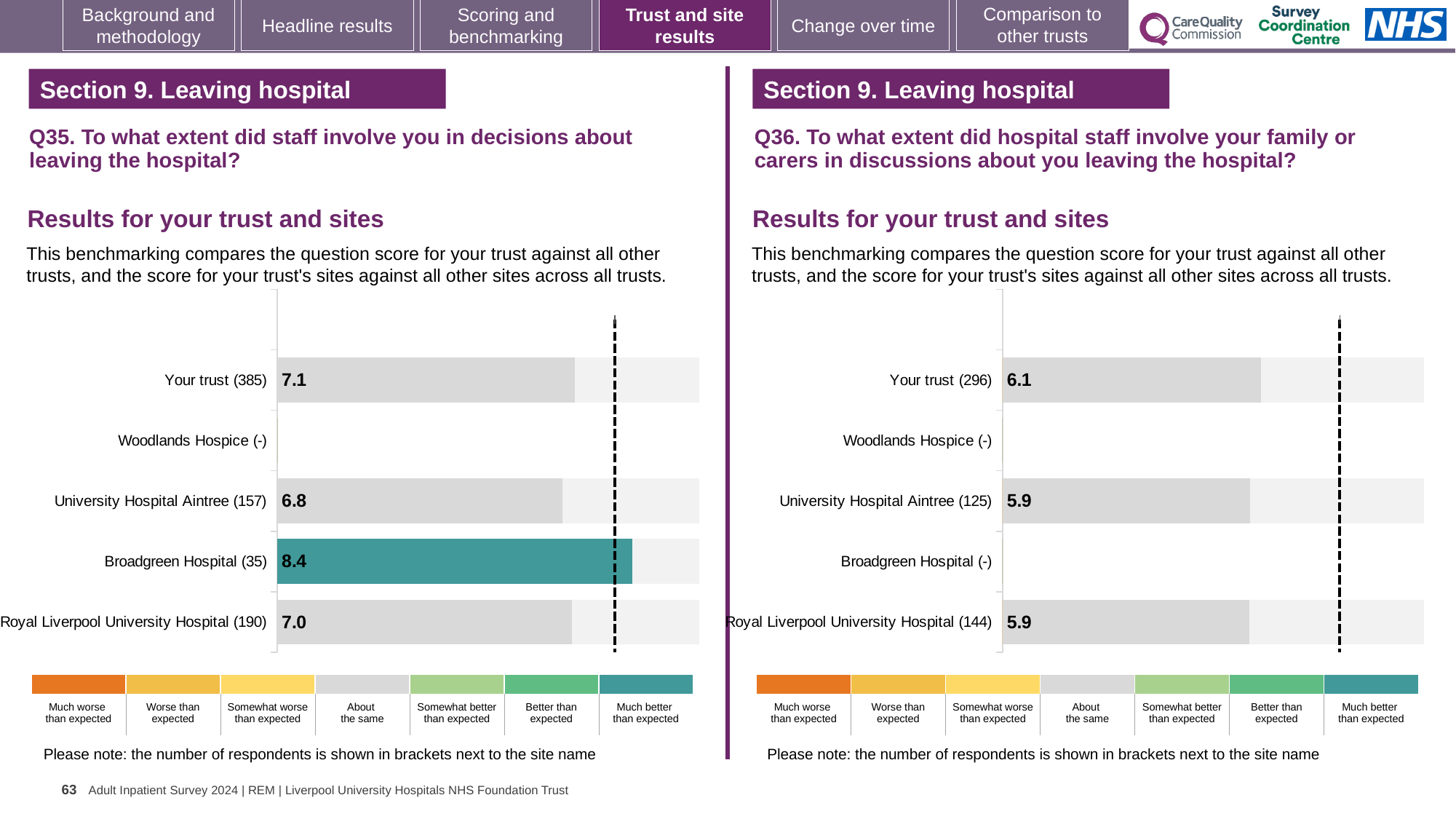
In the Q35 chart on the left, which site has the highest score? Broadgreen Hospital (35) In the Q35 chart on the left, what is the difference between the scores for Broadgreen Hospital (35) and Royal Liverpool University Hospital (190)? 1.4 What kind of chart is the Q35 chart on the left? Bar chart In the Q35 chart on the left, which has the higher score, Your trust (385) or University Hospital Aintree (157)? Your trust (385) In the Q36 chart on the right, what is the difference between the scores for Your trust (296) and University Hospital Aintree (125)? 0.2 In the Q35 chart on the left, what is the score for Your trust (385)? 7.1 In the Q35 chart on the left, which benchmark category does the colour of the Broadgreen Hospital (35) bar correspond to? Much better than expected In the Q36 chart on the right, what is the score for Your trust (296)? 6.1 In the Q36 chart on the right, what is the score for Royal Liverpool University Hospital (144)? 5.9 In the Q35 chart on the left, what is the score for Broadgreen Hospital (35)? 8.4 How many site rows are listed in the Q36 chart on the right? 5 In the Q35 chart on the left, what is the score for University Hospital Aintree (157)? 6.8